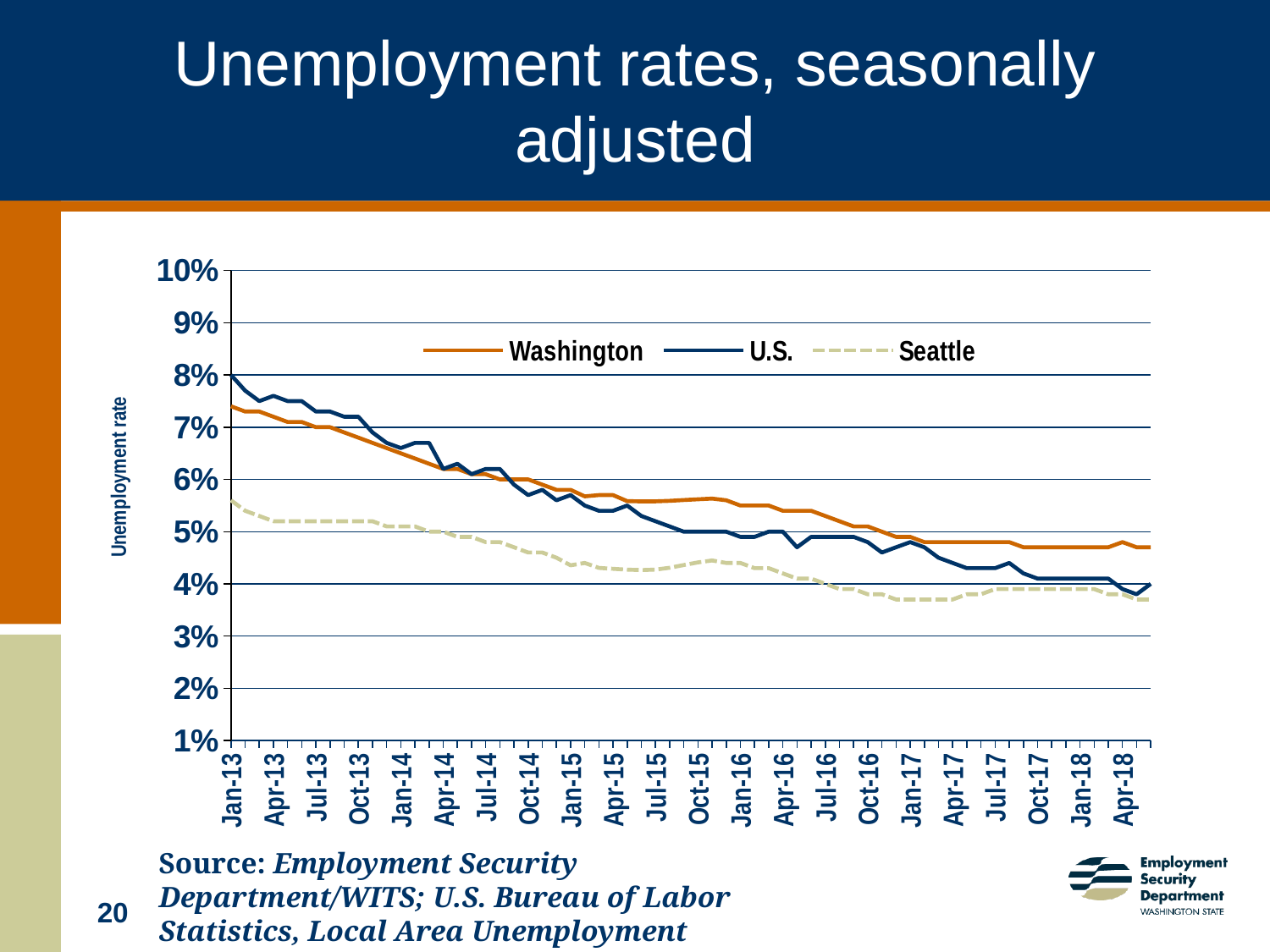
Which series are listed in the legend? Washington, U.S., Seattle Is the Seattle value at Apr-18 greater or less than 4%? less Is the Washington value at Jan-13 greater or less than 7%? greater What is the label on the vertical axis? Unemployment rate Which series has the highest value at Jan-13? U.S. What kind of chart is shown on the slide? line chart Which series has the highest value at Apr-18? Washington Is the Washington value at Apr-18 greater or less than 5%? less At Jan-18, which is larger, the Washington rate or the U.S. rate? Washington How many series does the legend list? 3 Do the unemployment rates generally rise or fall from Jan-13 to Apr-18? fall Which series has the lowest value across the whole period? Seattle